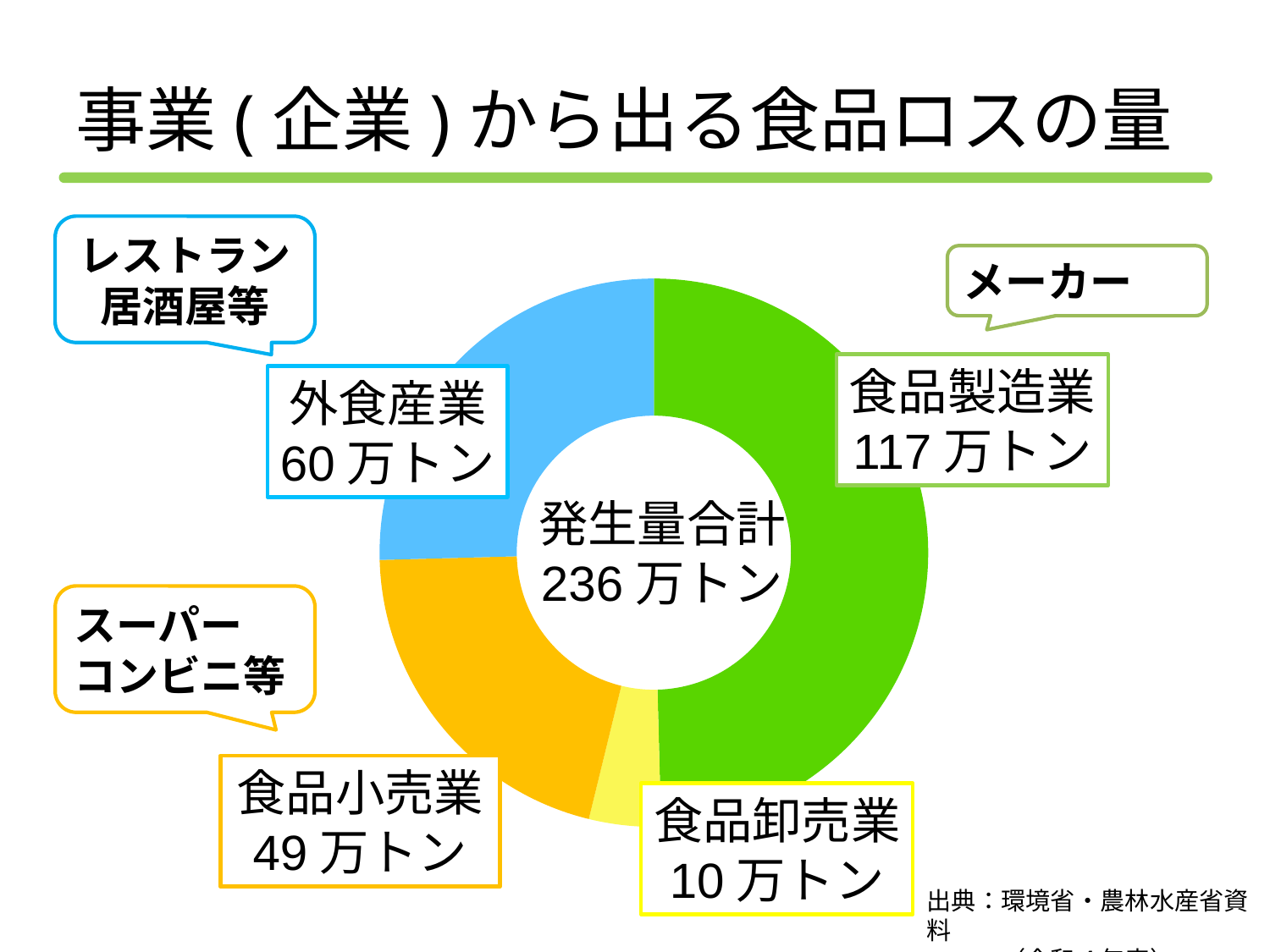
外食産業から出る食品ロスの量はいくらですか？ 60万トン グラフに示されている業種はいくつありますか？ 4 事業から出る食品ロスの発生量合計はいくらですか？ 236万トン 外食産業と食品小売業では、どちらの食品ロスの量が多いですか？ 外食産業 食品小売業から出る食品ロスの量はいくらですか？ 49万トン このグラフはどの種類のグラフですか？ 円グラフ（ドーナツグラフ） 食品小売業と食品卸売業の食品ロスの量の差はいくらですか？ 39万トン 食品ロスの発生量が最も多い業種はどれですか？ 食品製造業 食品ロスの発生量が最も少ない業種はどれですか？ 食品卸売業 食品製造業と外食産業の食品ロスの量の差はいくらですか？ 57万トン 食品製造業から出る食品ロスの量はいくらですか？ 117万トン 食品卸売業から出る食品ロスの量はいくらですか？ 10万トン